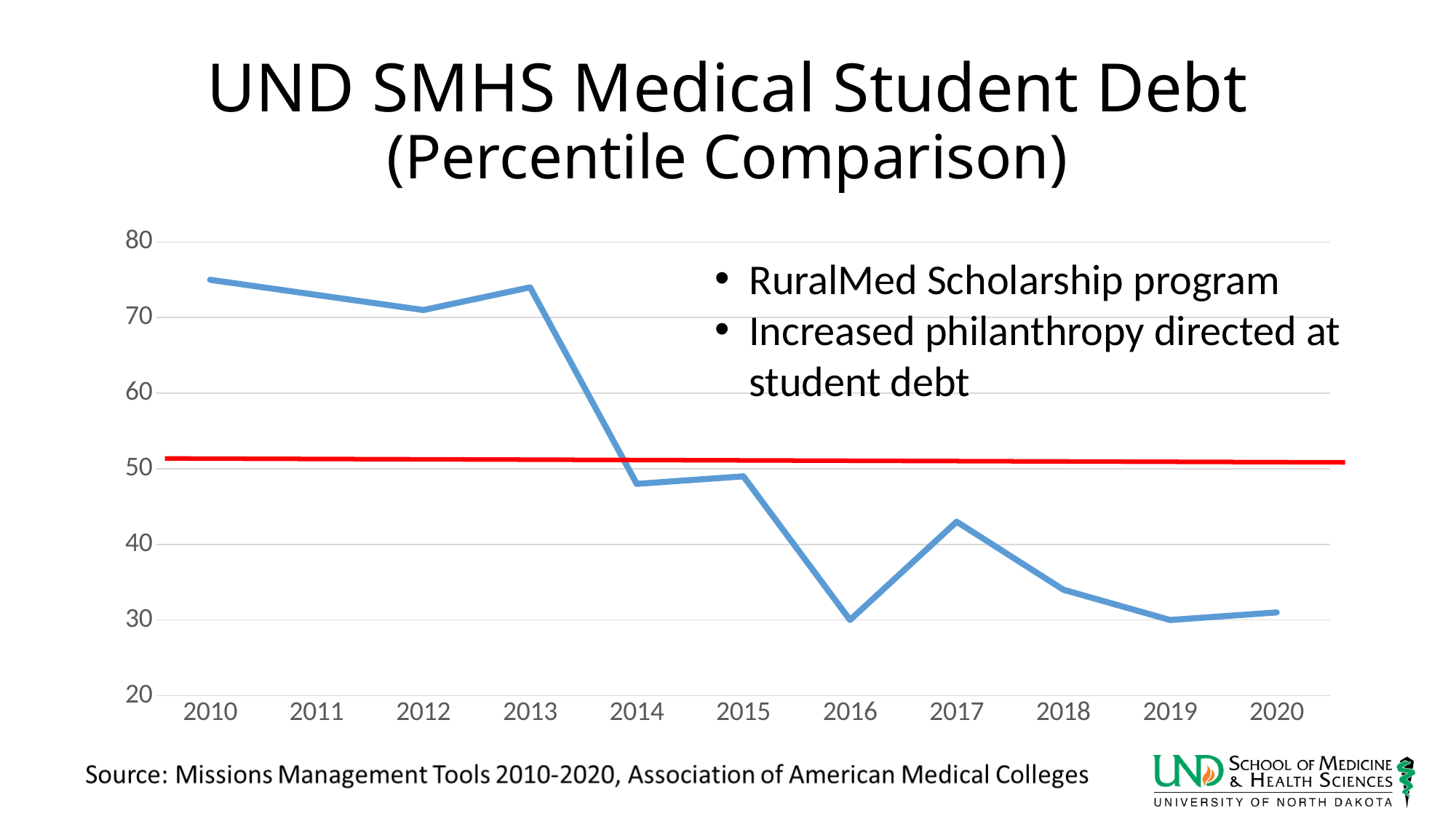
Does the blue line generally rise or fall from 2010 to 2020? fall Is the value of the blue line for 2018 greater or less than 40? less How many lines are plotted on the chart? 2 Is the value of the blue line for 2014 greater or less than 50? less Is the value of the blue line for 2017 greater or less than 40? greater Which year has the larger value on the blue line, 2010 or 2016? 2010 What is the title of the chart on the slide? UND SMHS Medical Student Debt (Percentile Comparison) What kind of chart is shown on the slide? line chart How many years are shown along the x axis of the chart? 11 Which year has the larger value on the blue line, 2013 or 2014? 2013